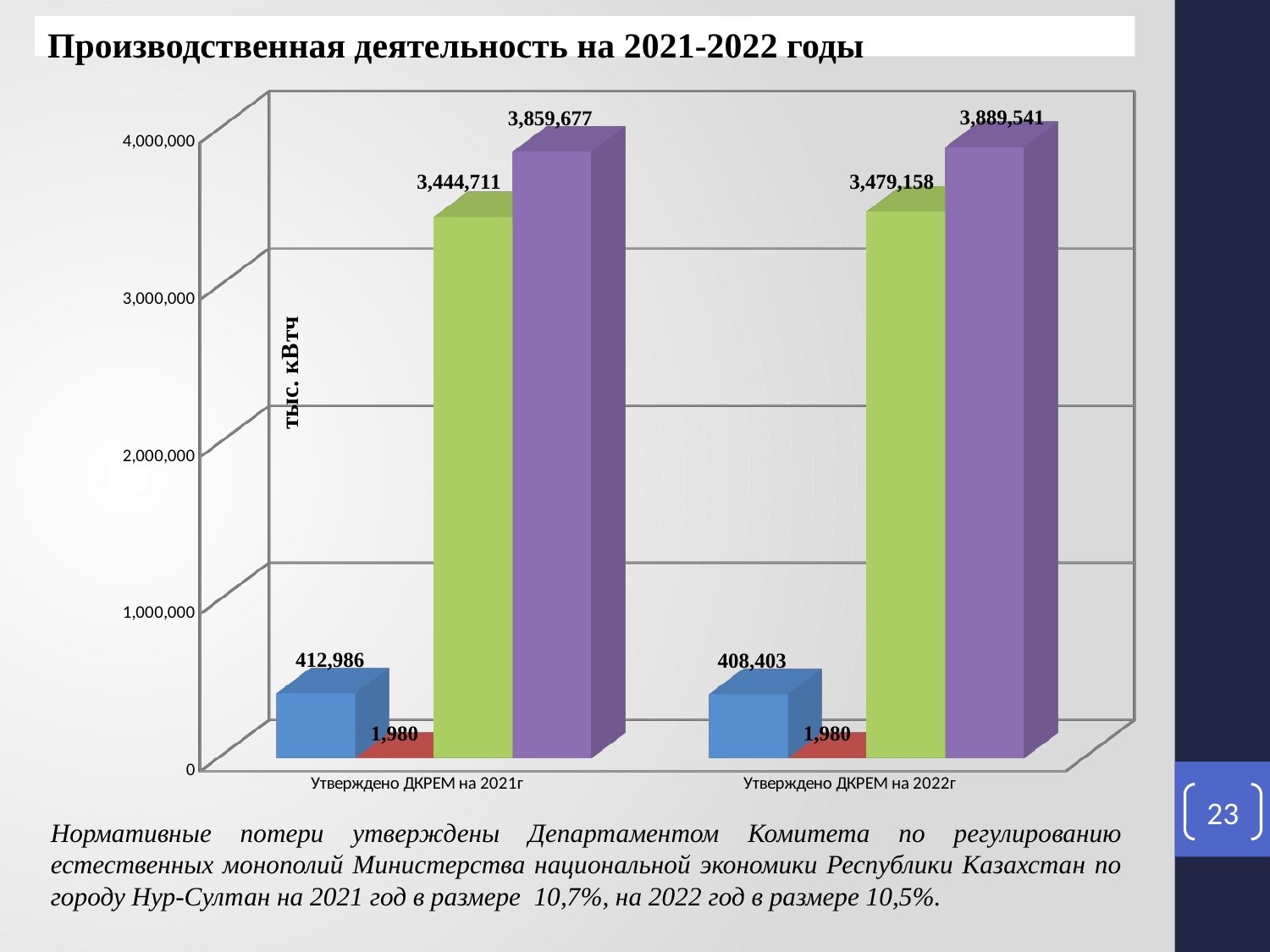
What is the label of the vertical axis? тыс. кВтч What is the value of the red bar for 'Утверждено ДКРЕМ на 2022г'? 1,980 How many categories are shown on the x axis? 2 What is the value of the purple bar for 'Утверждено ДКРЕМ на 2021г'? 3,859,677 Which is larger: the blue bar for 2021 or the blue bar for 2022? The blue bar for 2021 (412,986) Which bar has the lowest value in the 'Утверждено ДКРЕМ на 2021г' group? The red bar (1,980) What is the value of the green bar for 'Утверждено ДКРЕМ на 2022г'? 3,479,158 What is the value of the blue bar for 'Утверждено ДКРЕМ на 2021г'? 412,986 What is the difference between the purple bar values for 2022 and 2021? 29,864 What type of chart is shown on the slide? Bar chart What is the difference between the purple and green bars for 'Утверждено ДКРЕМ на 2021г'? 414,966 Which bar has the highest value in the 'Утверждено ДКРЕМ на 2022г' group? The purple bar (3,889,541)